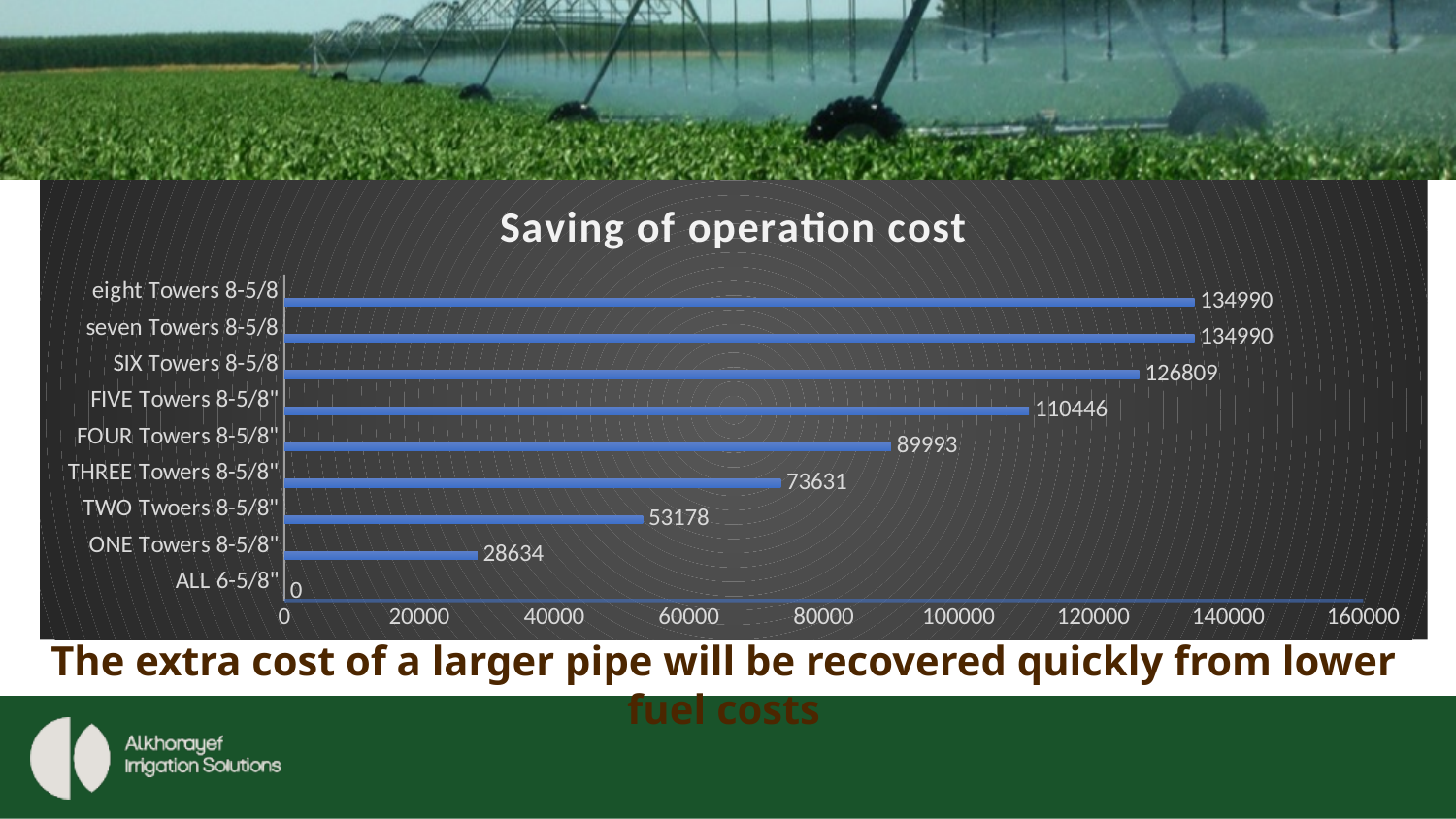
What is the value for SIX Towers 8-5/8 in the Saving of operation cost chart? 126809 Is the value for FIVE Towers 8-5/8" greater or less than 100000? greater How many categories are shown in the Saving of operation cost chart? 9 What is the value for ONE Towers 8-5/8" in the chart? 28634 Which is larger, the value for FOUR Towers 8-5/8" or the value for THREE Towers 8-5/8"? FOUR Towers 8-5/8" What is the value for THREE Towers 8-5/8" in the chart? 73631 What is the value for ALL 6-5/8" in the chart? 0 What is the difference between the values for FIVE Towers 8-5/8" and FOUR Towers 8-5/8"? 20453 What kind of chart is shown on the slide? bar chart What is the difference between the values for SIX Towers 8-5/8 and TWO Twoers 8-5/8"? 73631 What is the title of the chart on the slide? Saving of operation cost Which category has the lowest value in the Saving of operation cost chart? ALL 6-5/8"